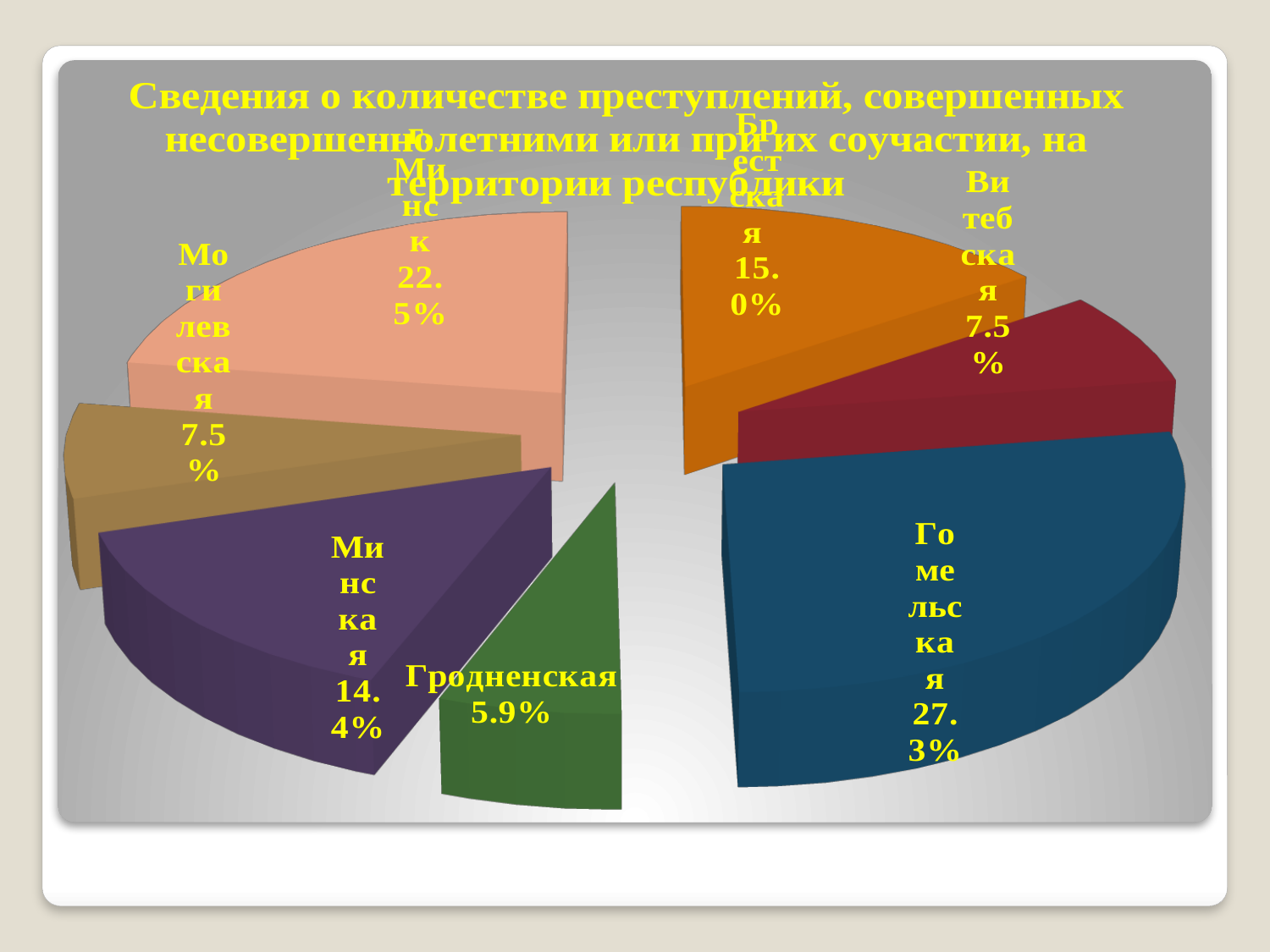
Which region has the largest slice of the pie? Гомельская What share of the pie does Гомельская have? 27.3% Which is larger, the share for Брестская or the share for Минская? Брестская What is the difference in percentage points between Гомельская and Минск? 4.8 What share of the pie does Брестская have? 15.0% Which region has the smallest slice of the pie? Гродненская What share of the pie does Гродненская have? 5.9% What share of the pie does Минск have? 22.5% What share of the pie does Минская have? 14.4% What kind of chart is shown on the slide? pie chart How many slices does the pie chart have? 7 What is the title of the chart? Сведения о количестве преступлений, совершенных несовершеннолетними или при их соучастии, на территории республики